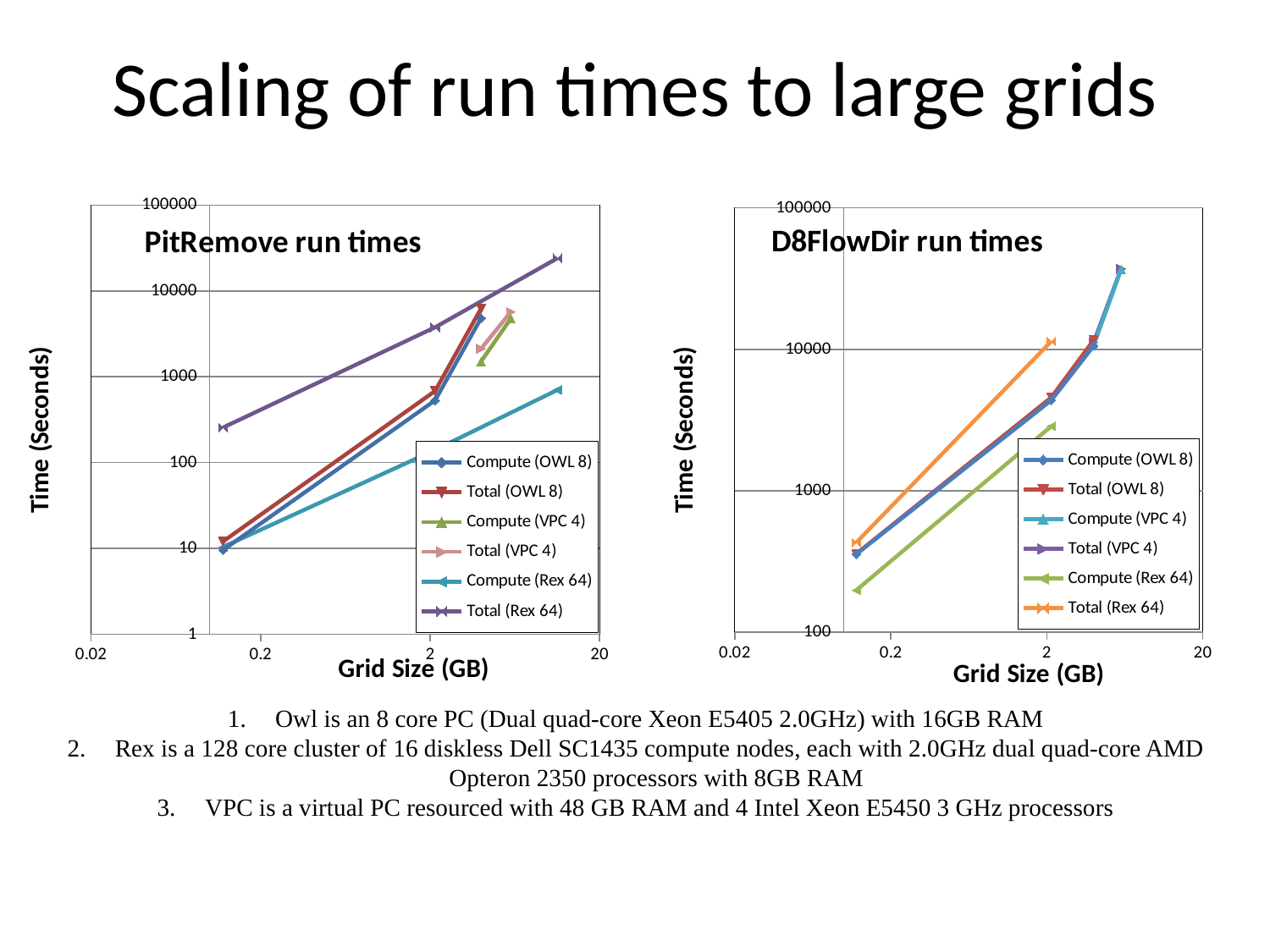
How many series does the legend of the D8FlowDir run times chart list? 6 In the PitRemove run times chart, which series reaches the highest run time? Total (Rex 64) What is the label of the x axis on the D8FlowDir run times chart? Grid Size (GB) How many series does the legend of the PitRemove run times chart list? 6 In the PitRemove run times chart, is the Total (Rex 64) value at the largest grid size greater or less than 10000? greater In the D8FlowDir run times chart, does the Total (Rex 64) series rise or fall as grid size increases? rise In the PitRemove run times chart, is the Compute (Rex 64) value at the largest grid size greater or less than 1000? less In the D8FlowDir run times chart, is the Total (VPC 4) value at the largest grid size greater or less than 10000? greater In the PitRemove run times chart, do the run times rise or fall as grid size increases? rise What kind of chart is the PitRemove run times chart? line chart